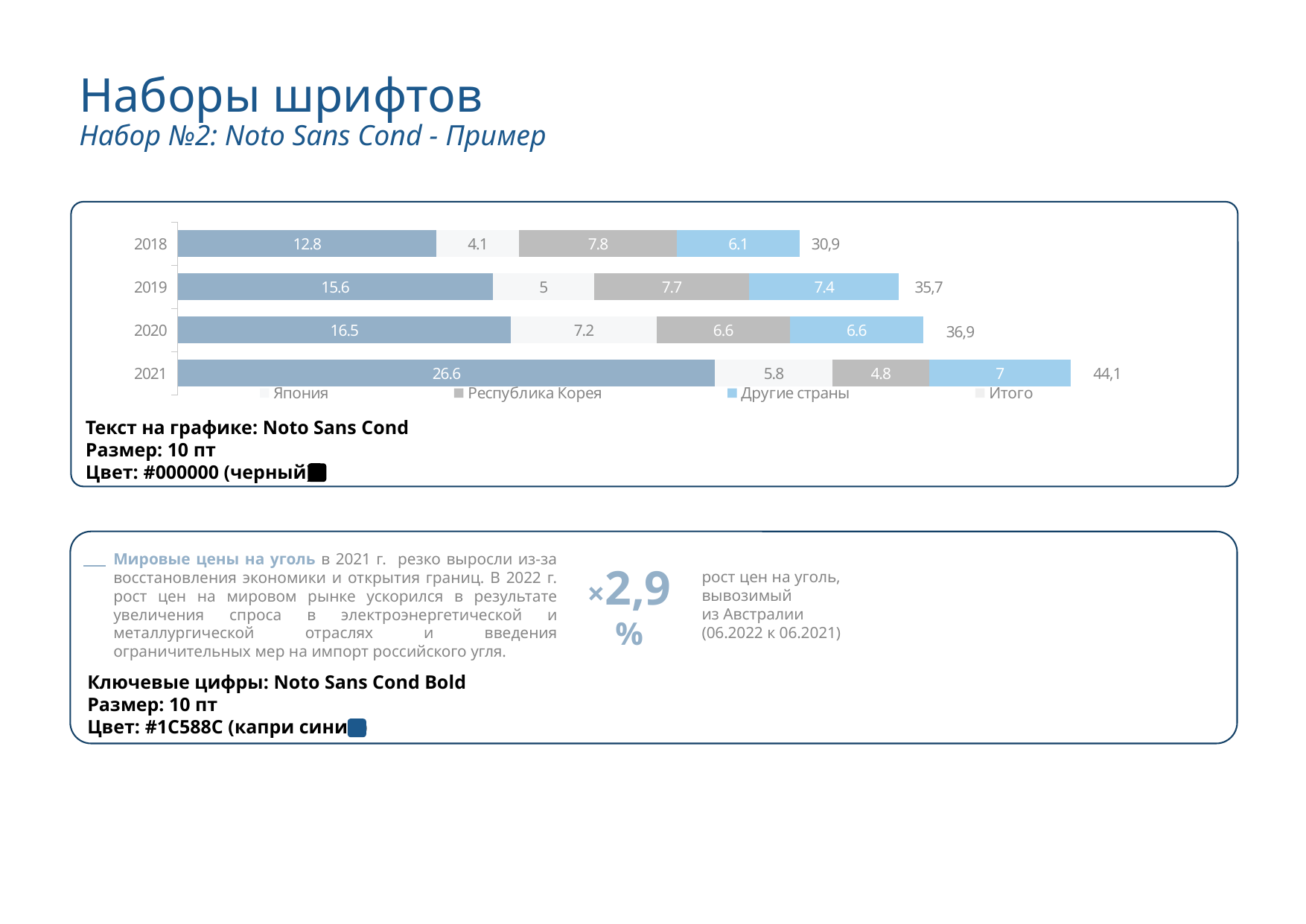
Which year has the larger value for Япония, 2019 or 2020? 2020 What kind of chart is shown on the slide? Stacked bar chart Do the totals rise or fall from 2018 to 2021? Rise What is the value for Япония in 2021? 5.8 What is the value for Республика Корея in 2019? 7.7 What is the total value shown for the 2021 bar? 44,1 What is the difference between the values for Другие страны in 2019 and 2018? 1.3 How many years are shown on the chart? 4 What is the value for Другие страны in 2020? 6.6 What is the difference between the totals for 2021 and 2018? 13,2 Which year has the highest total? 2021 Which year has the lowest total? 2018